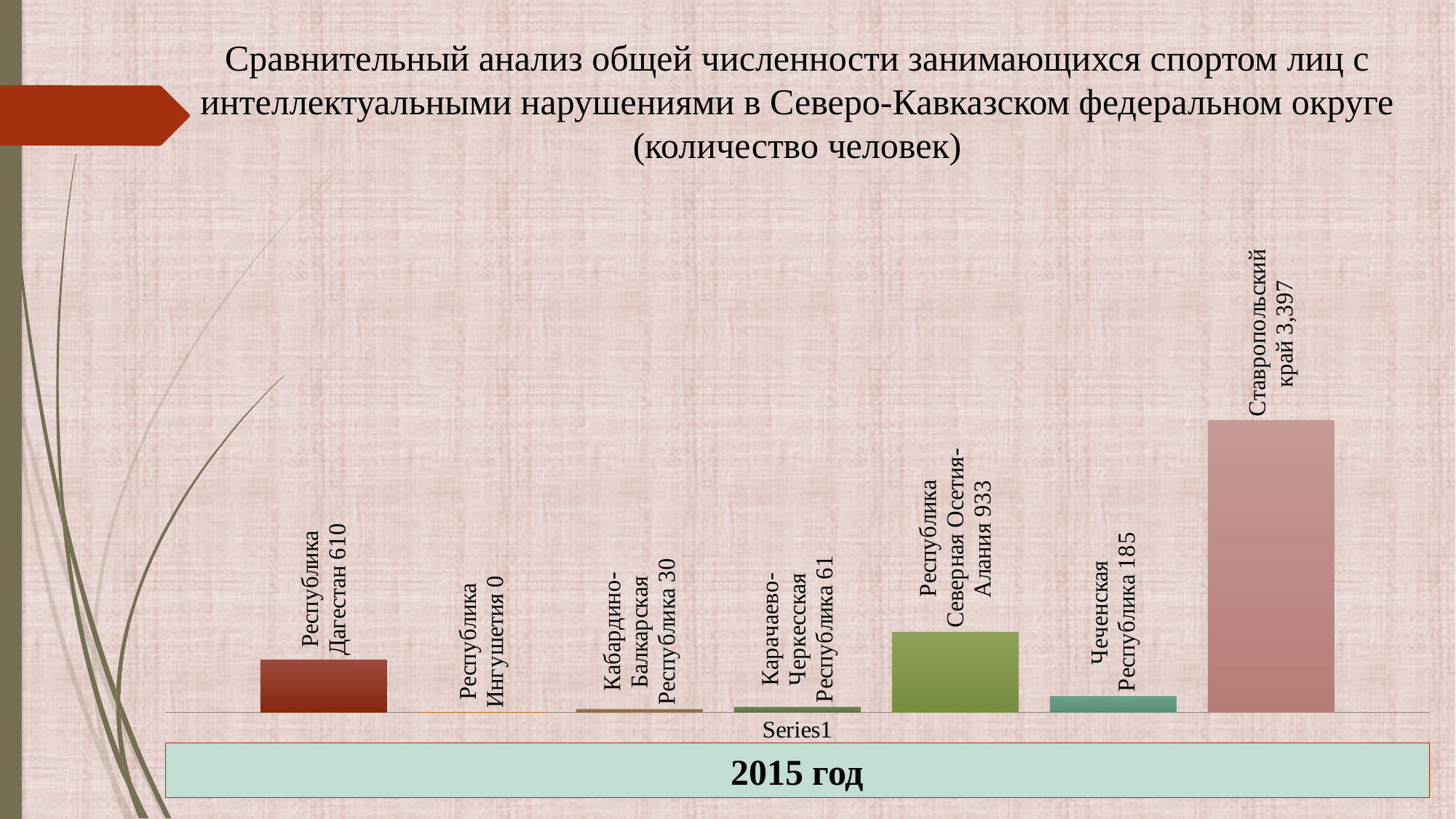
Which region has the lowest value? Республика Ингушетия What is the value for Республика Ингушетия? 0 What is the value for Чеченская Республика? 185 How many regions are shown in the chart? 7 What is the value for Республика Северная Осетия-Алания? 933 What is the difference between the values for Республика Северная Осетия-Алания and Республика Дагестан? 323 What kind of chart is shown on the slide? Bar chart What year is shown in the box below the chart? 2015 год Which region has the highest value? Ставропольский край What is the value for Ставропольский край? 3,397 Which is larger, the value for Карачаево-Черкесская Республика or Кабардино-Балкарская Республика? Карачаево-Черкесская Республика What is the value for Республика Дагестан? 610